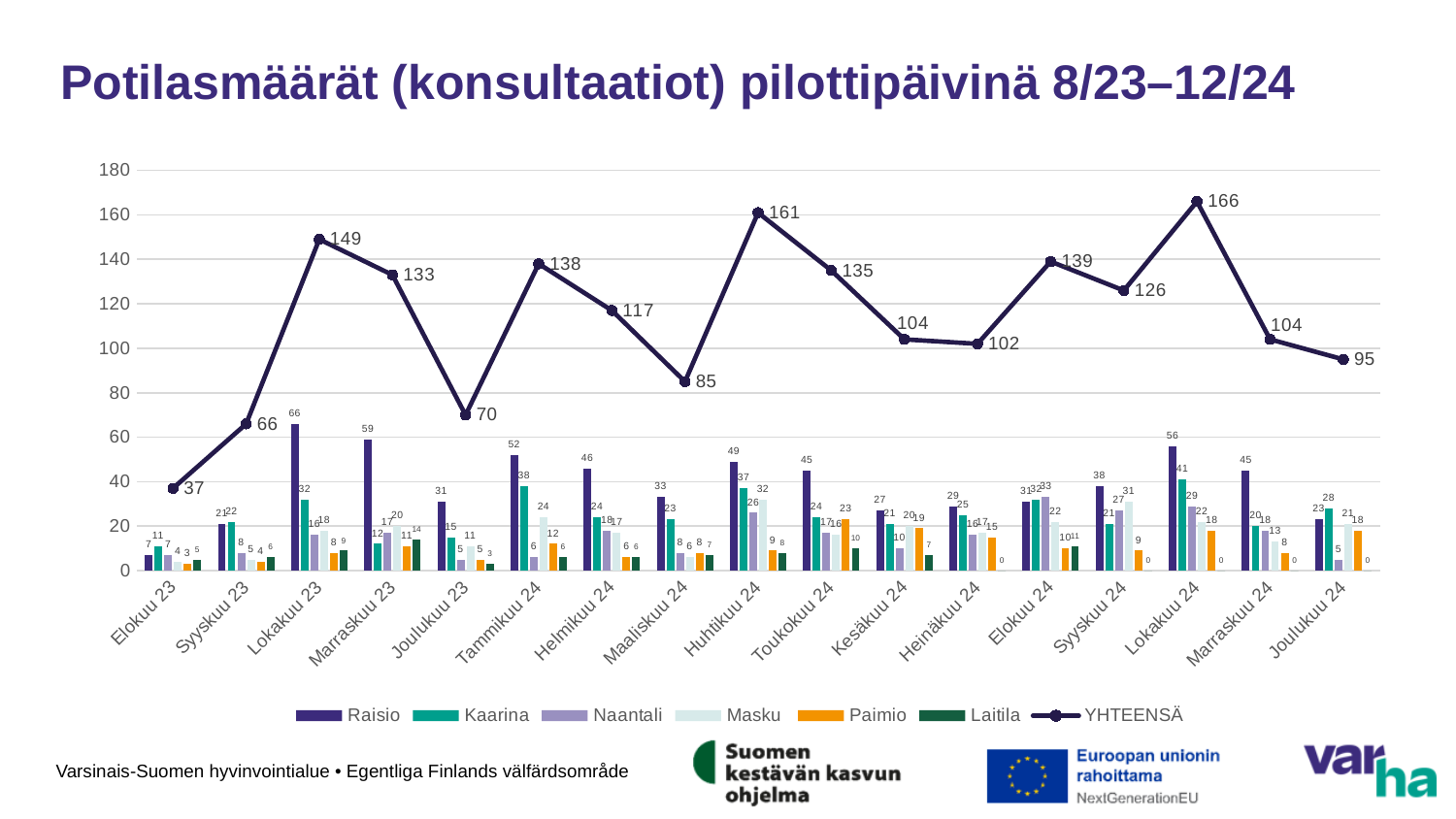
What is the difference between the YHTEENSÄ values for Lokakuu 24 and Marraskuu 24? 62 Which month has the larger YHTEENSÄ value, Tammikuu 24 or Helmikuu 24? Tammikuu 24 Does the YHTEENSÄ line rise or fall from Elokuu 23 to Lokakuu 23? Rises What is the YHTEENSÄ value for Huhtikuu 24? 161 What is the YHTEENSÄ value for Joulukuu 23? 70 What is the Raisio value for Lokakuu 23? 66 How many months are shown on the x axis? 17 What kind of chart is shown on the slide? A combined bar and line chart How many series does the legend list? 7 In which month is the YHTEENSÄ line at its lowest? Elokuu 23 In which month is the YHTEENSÄ line at its highest? Lokakuu 24 What is the title of the chart? Potilasmäärät (konsultaatiot) pilottipäivinä 8/23–12/24